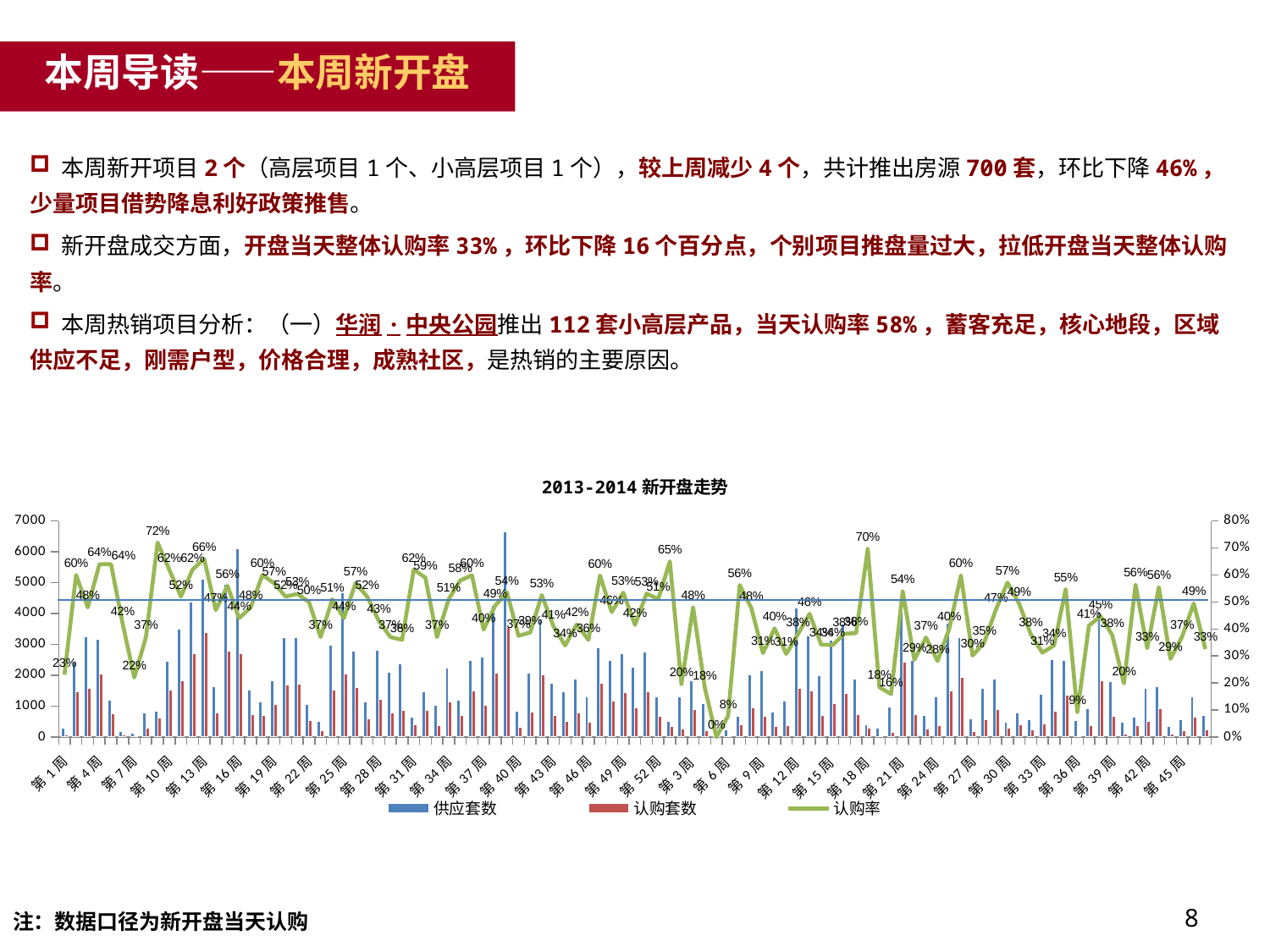
Which is larger, the 认购率 label of 72% or the label of 65%? 72% What is the title of the chart? 2013-2014 新开盘走势 What is the maximum value shown on the right-hand percentage axis? 80% What is the difference between the highest 认购率 label (72%) and the second-highest label (70%)? 2 percentage points Is the tallest 供应套数 bar greater or less than 6000? greater What is the highest 认购率 value labelled on the chart? 72% Which series is plotted as a line rather than bars? 认购率 What is the maximum value shown on the left-hand axis? 7000 What kind of chart is shown on the slide? A combined bar and line chart How many series does the chart legend list? 3 What is the lowest 认购率 value labelled on the chart? 0% What is the 认购率 value labelled at 第1周? 23%